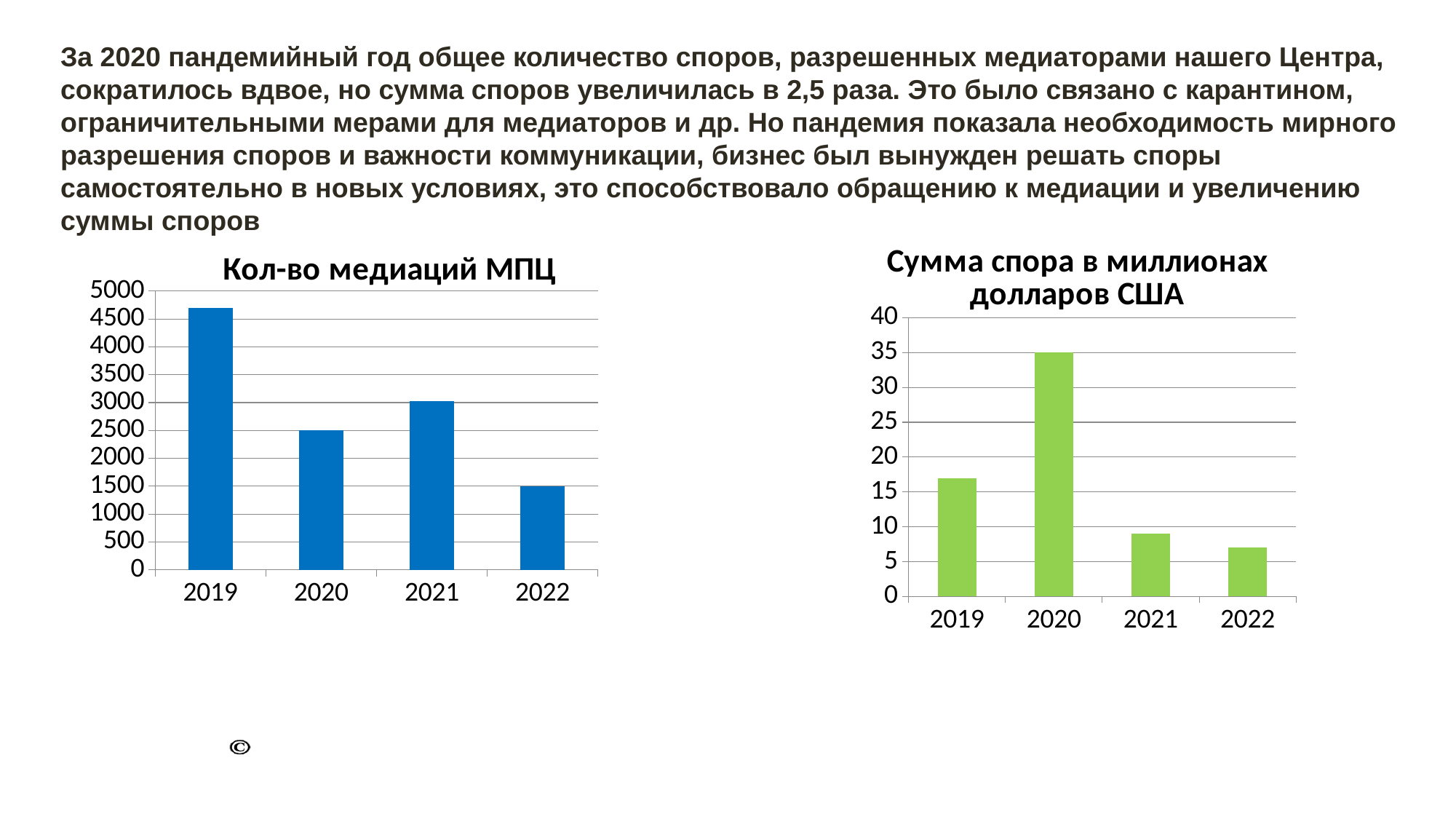
In the chart titled "Кол-во медиаций МПЦ", which is larger, the value for 2020 or the value for 2021? 2021 In the chart titled "Сумма спора в миллионах долларов США", what is the value for 2020? 35 In the chart titled "Кол-во медиаций МПЦ", what is the difference between the values for 2020 and 2022? 1000 In the chart titled "Сумма спора в миллионах долларов США", which year has the lowest value? 2022 What kind of chart is the chart titled "Кол-во медиаций МПЦ"? bar chart In the chart titled "Сумма спора в миллионах долларов США", is the value for 2021 greater or less than 10? less In the chart titled "Кол-во медиаций МПЦ", what is the value for 2022? 1500 In the chart titled "Сумма спора в миллионах долларов США", do the values rise or fall from 2020 to 2022? fall How many years are shown on the x axis of the chart titled "Сумма спора в миллионах долларов США"? 4 In the chart titled "Кол-во медиаций МПЦ", what is the value for 2020? 2500 In the chart titled "Кол-во медиаций МПЦ", which year has the highest value? 2019 In the chart titled "Кол-во медиаций МПЦ", is the value for 2019 greater or less than 4500? greater